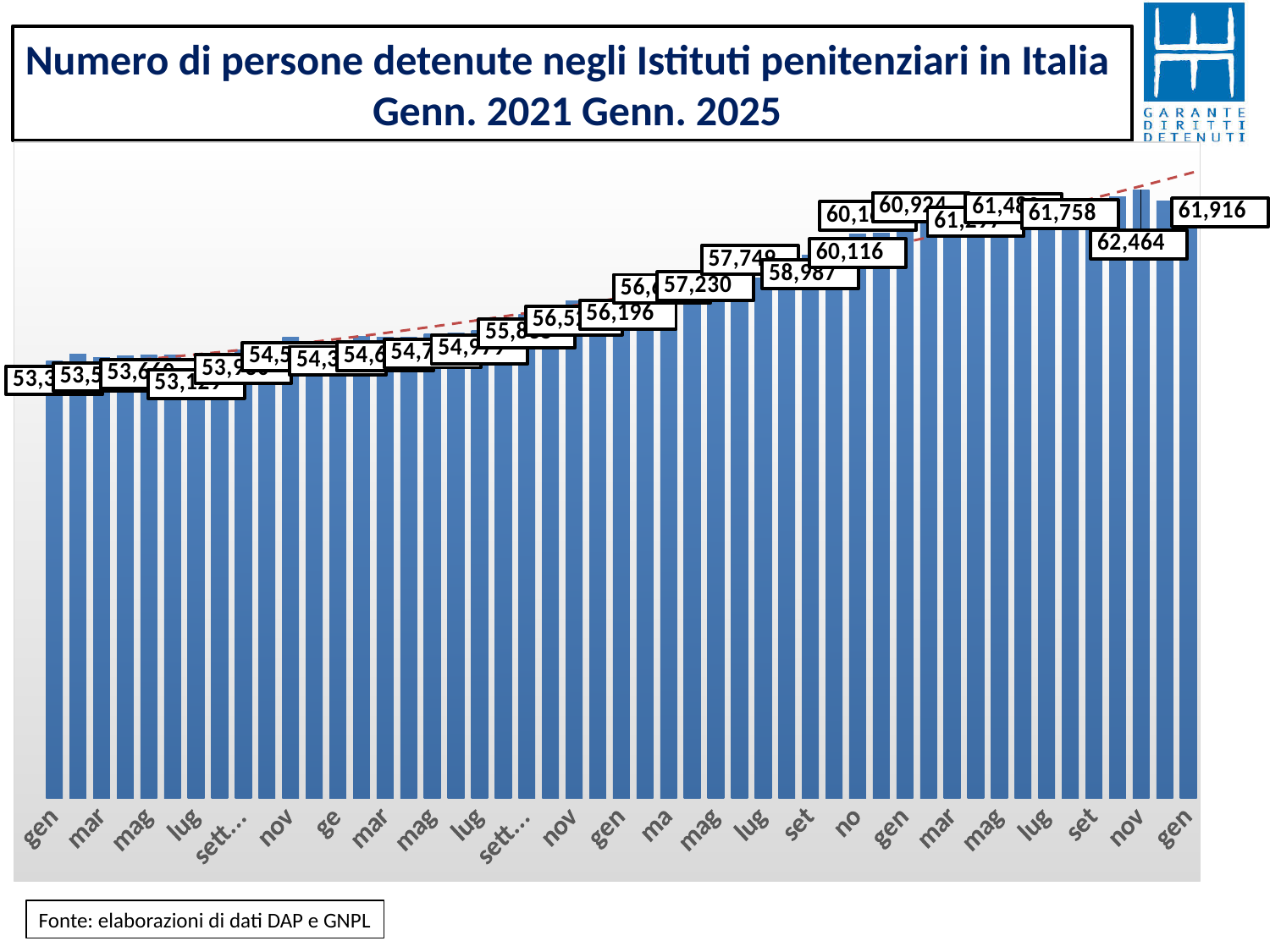
What colour are the bars in the chart? blue What source is cited below the chart? Fonte: elaborazioni di dati DAP e GNPL Which is larger, the value labelled 60,116 or the value labelled 58,987? 60,116 How many bars (months) are plotted on the chart? 49 What kind of chart is shown on the slide? bar chart What is the difference between the highest printed value (62,464) and the last bar's value (61,916)? 548 What is the value shown for the last bar (gen 2025)? 61,916 What is the lowest value printed on the chart? 53,129 What is the highest value printed on the chart? 62,464 Do the values generally rise or fall from gen 2021 to gen 2025 along the x axis? rise Which bar is taller, the first bar (gen 2021) or the last bar (gen 2025)? the last bar (gen 2025)